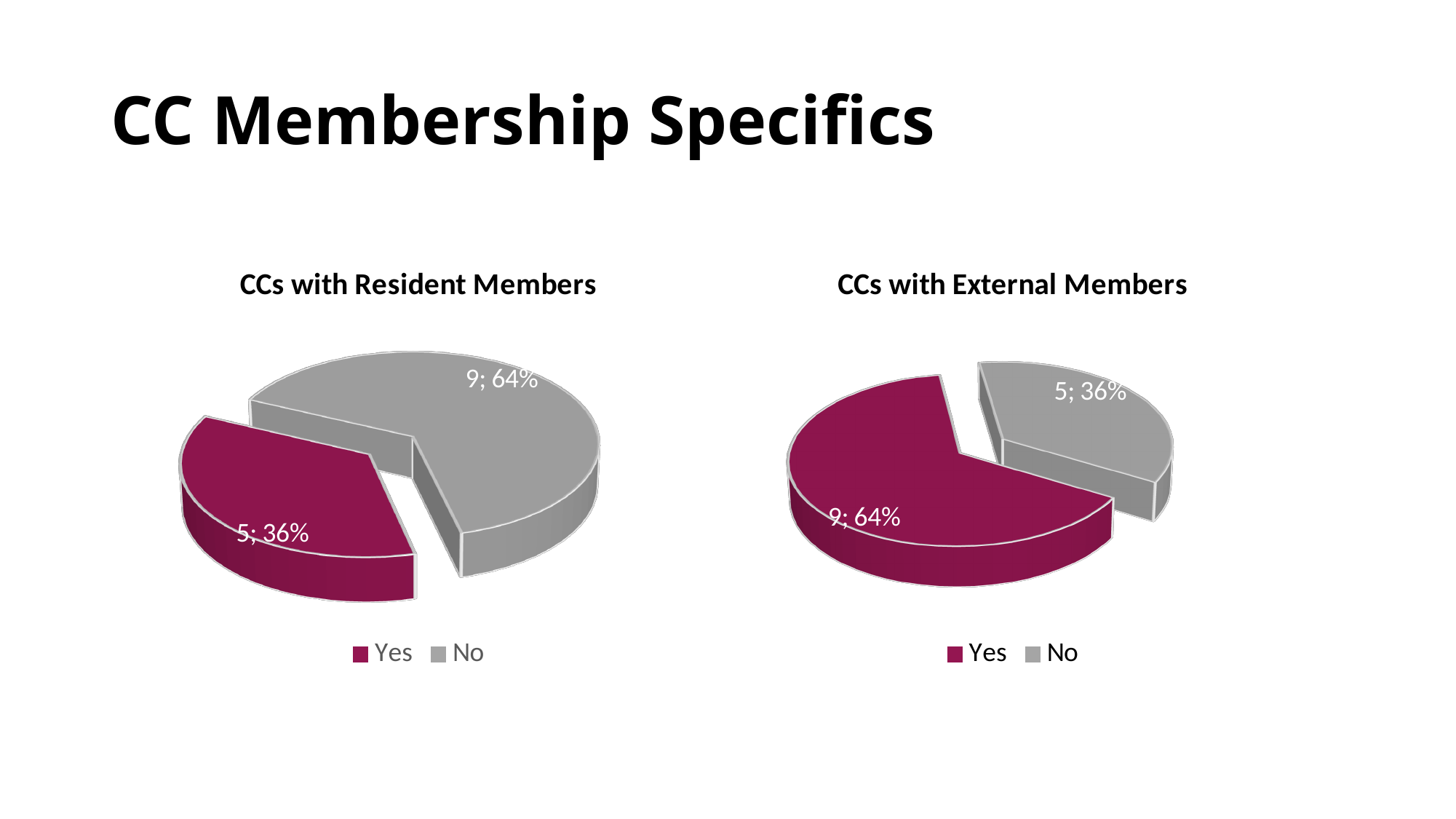
In the 'CCs with External Members' chart, which category is the smallest? No In the 'CCs with External Members' chart, what is the value for Yes? 9 In the 'CCs with Resident Members' chart, what share of the pie is the No slice? 64% In the 'CCs with External Members' chart, what is the value for No? 5 In the 'CCs with External Members' chart, what share of the pie is the Yes slice? 64% What kind of chart is the 'CCs with External Members' chart? Pie chart In the 'CCs with Resident Members' chart, what is the value for Yes? 5 In the 'CCs with Resident Members' chart, how many categories does the legend list? 2 In the 'CCs with External Members' chart, what is the difference between the Yes and No values? 4 In the 'CCs with Resident Members' chart, which is larger, Yes or No? No In the 'CCs with Resident Members' chart, which category is the largest? No In the 'CCs with Resident Members' chart, what is the value for No? 9